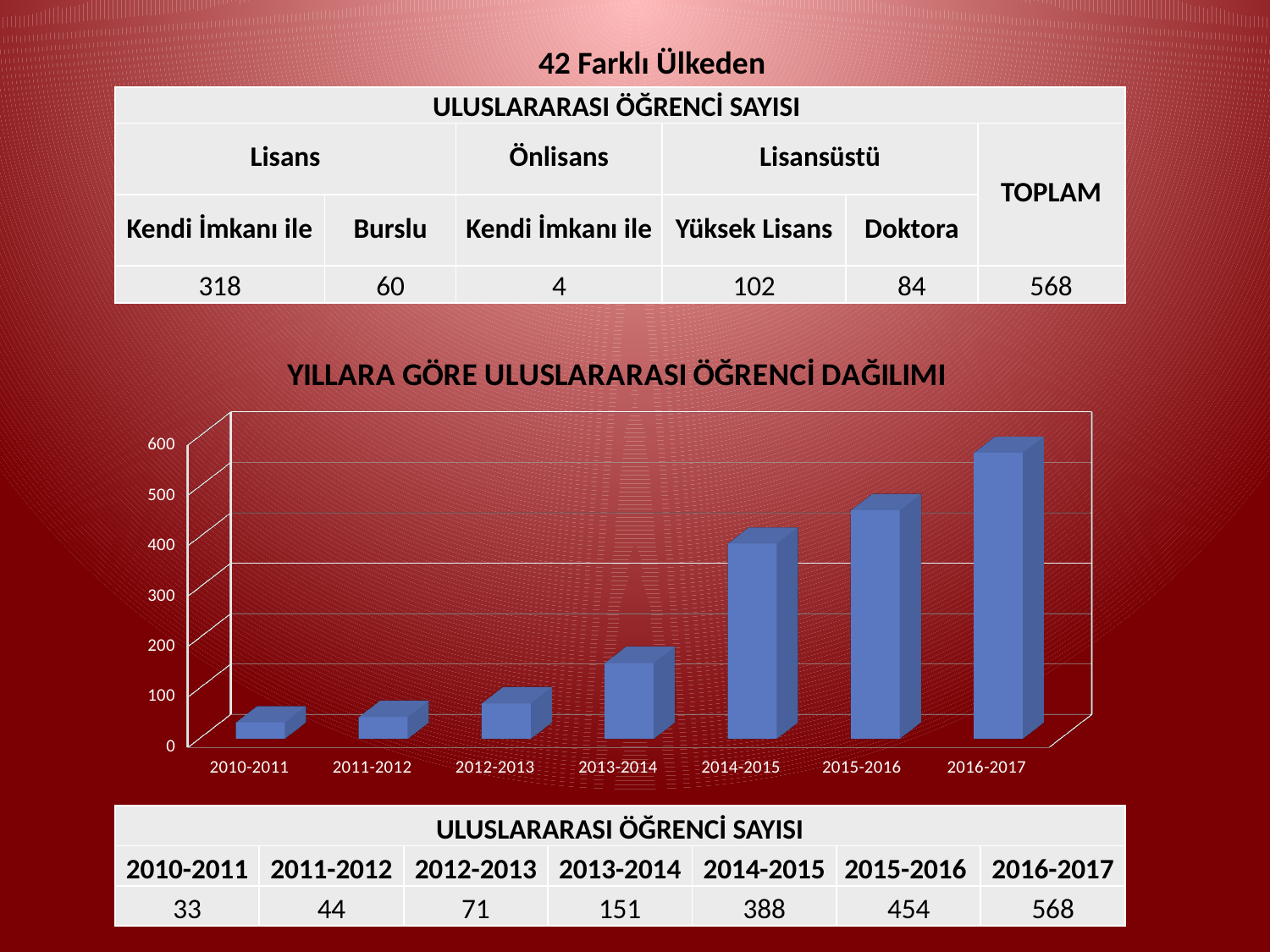
What is the title of the bar chart on the slide? YILLARA GÖRE ULUSLARARASI ÖĞRENCİ DAĞILIMI What is the difference between the international student counts for 2016-2017 and 2015-2016? 114 According to the slide, what is the international student count for 2013-2014? 151 Do the values in the chart rise or fall from 2010-2011 to 2016-2017? rise Is the value for 2012-2013 in the chart greater or less than 100? less What kind of chart is shown under the title 'YILLARA GÖRE ULUSLARARASI ÖĞRENCİ DAĞILIMI'? bar chart Which academic year has the highest bar in the chart? 2016-2017 Which academic year has the lowest bar in the chart? 2010-2011 Which is larger in the chart, the bar for 2014-2015 or the bar for 2013-2014? 2014-2015 How many academic years are shown on the x axis of the chart? 7 Is the value for 2015-2016 in the chart greater or less than 400? greater According to the slide, what is the international student count for 2014-2015? 388